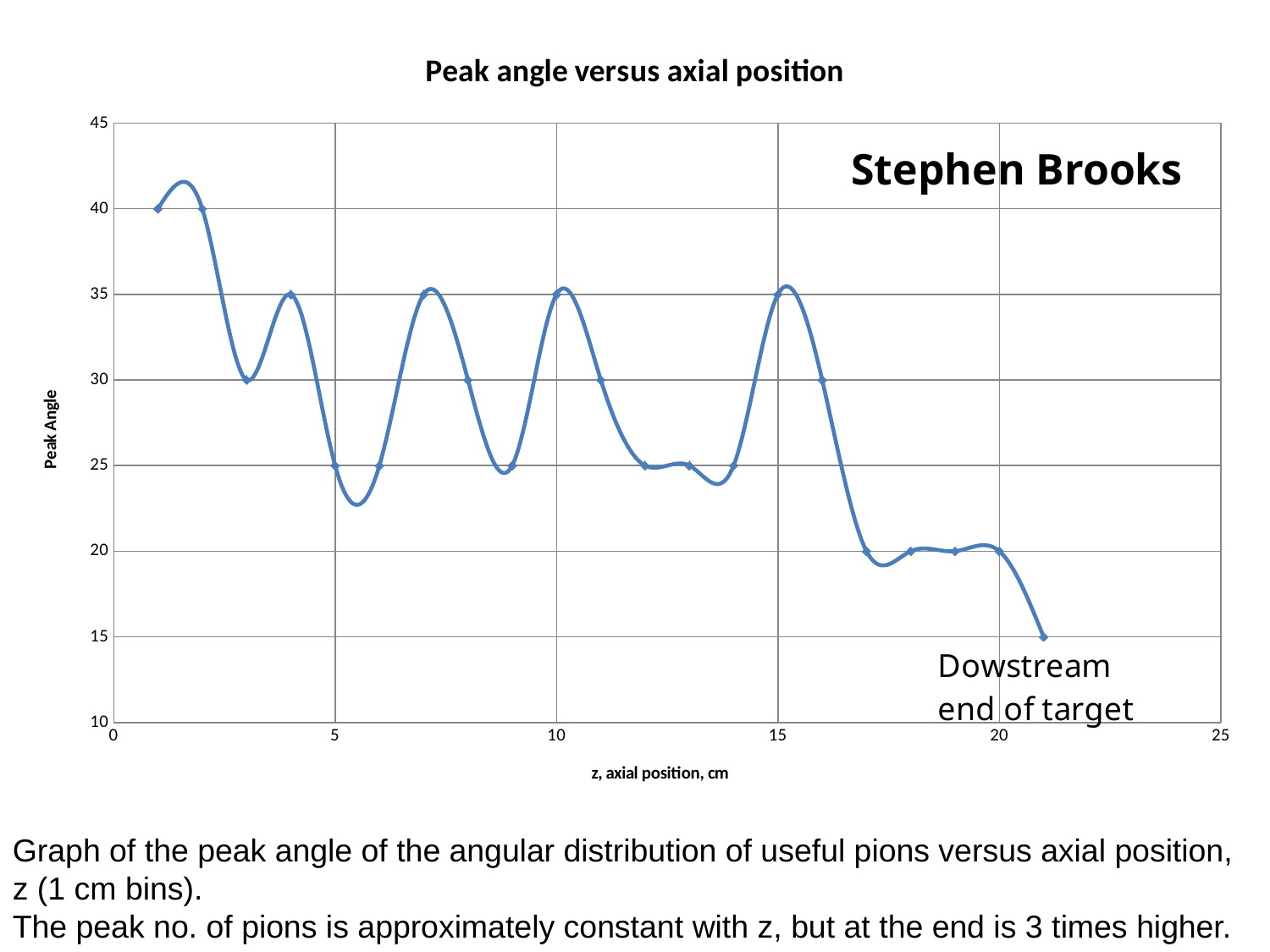
Is the peak angle at z = 10 cm greater or less than 30? greater What type of chart is shown on the slide? line chart What is the peak angle at z = 18 cm? 20 What is the peak angle at z = 1 cm? 40 At which axial position z is the peak angle lowest? 21 Is the peak angle at z = 17 cm greater or less than 25? less What is the peak angle at z = 21 cm? 15 Which has a larger peak angle, z = 1 cm or z = 21 cm? z = 1 cm Is the peak angle at z = 5 cm greater or less than 30? less What is the title of the chart? Peak angle versus axial position What is the label of the x axis? z, axial position, cm Overall, does the peak angle rise or fall as z increases from 1 to 21 cm? fall